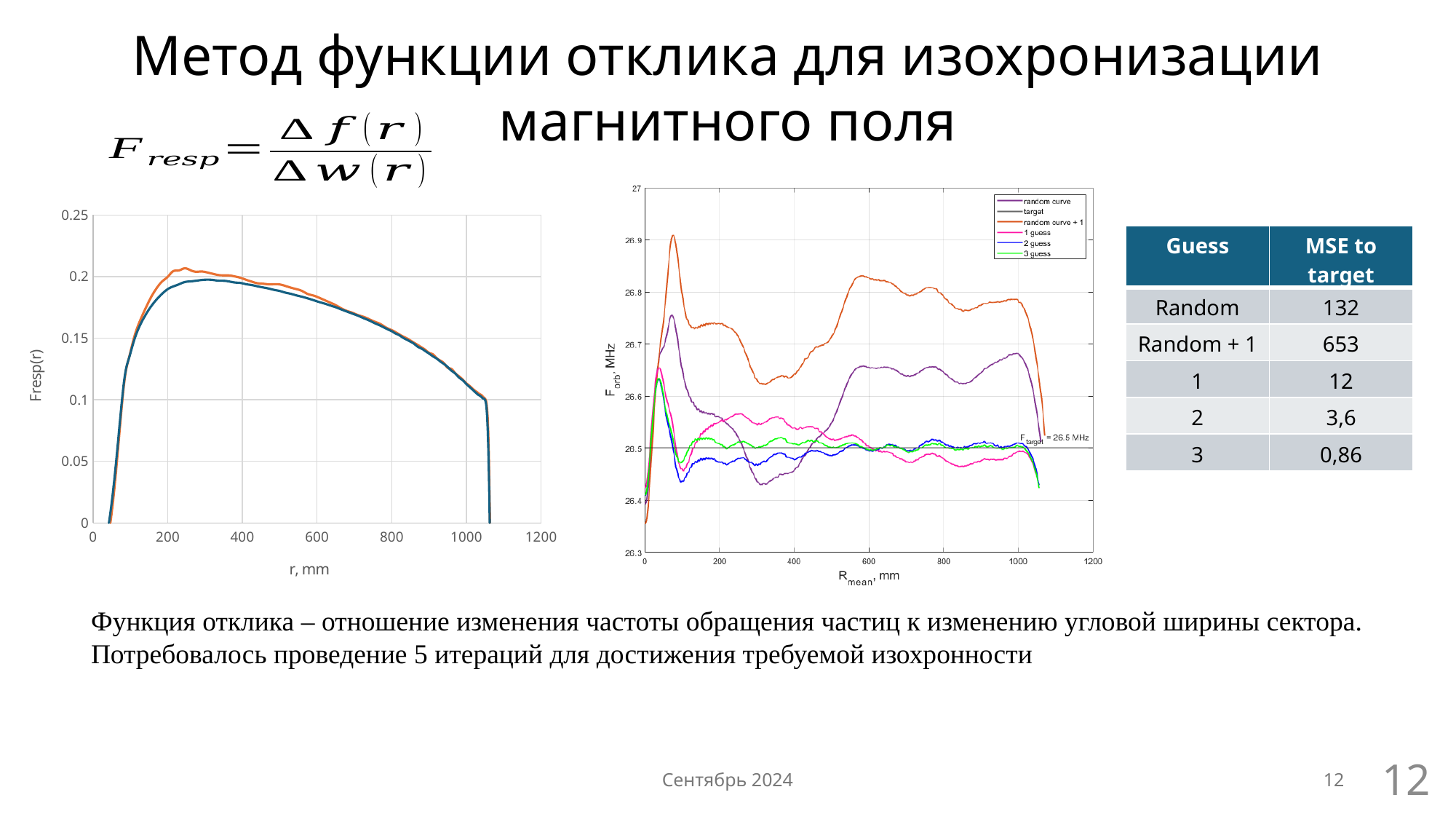
In the left chart, what is the label of the x axis? r, mm What kind of chart is the right chart (F_orb, MHz versus R_mean, mm)? line chart In the right chart, which series reaches the highest F_orb value? random curve + 1 In the left chart, is the value of the curves at r = 800 mm greater or less than 0.2? less In the right chart, how many series does the legend list? 6 In the left chart, do the curves rise or fall as r increases from 400 mm to 1000 mm? fall In the right chart, what is the label of the x axis? R_mean, mm In the left chart, how many curves are plotted? 2 What kind of chart is the left chart (Fresp(r) versus r, mm)? line chart In the left chart, is the value of the curves at r = 600 mm greater or less than 0.15? greater In the right chart, is the peak value of the 'random curve + 1' series greater or less than 26.8 MHz? greater In the right chart, what target frequency value is printed next to the horizontal target line? 26.5 MHz